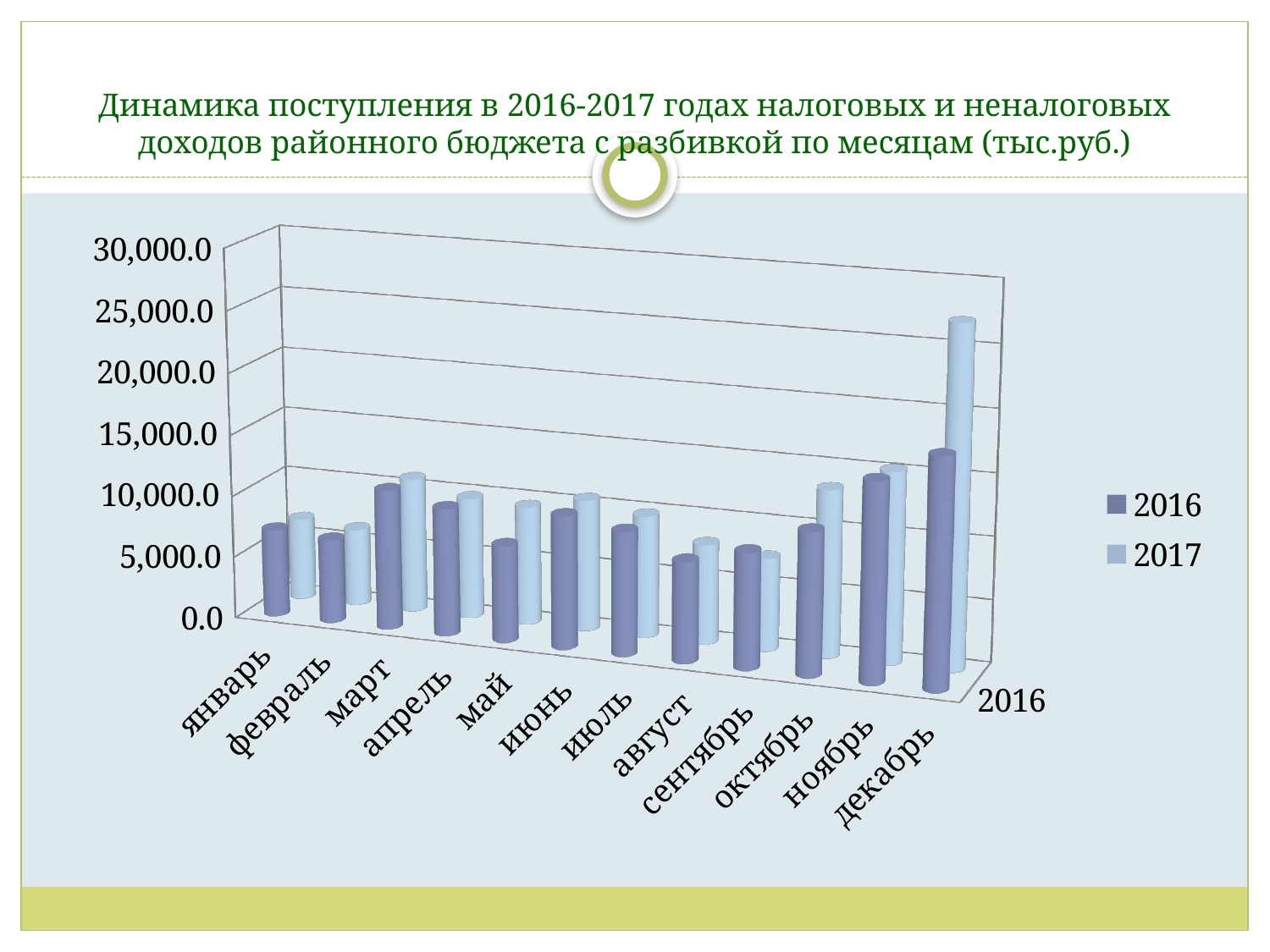
Which month has the highest value for the 2017 series? декабрь Is the value for май in the 2016 series greater or less than 10,000.0? less Is the value for декабрь in the 2016 series greater or less than 10,000.0? greater Is the value for декабрь in the 2017 series greater or less than 20,000.0? greater How many months (categories) are shown on the x axis? 12 For май, which series has the larger value, 2016 or 2017? 2017 Which series are listed in the legend? 2016 and 2017 Which month has the highest value for the 2016 series? декабрь For декабрь, which series has the larger value, 2016 or 2017? 2017 How many series does the legend list? 2 What kind of chart is shown on the slide? bar chart